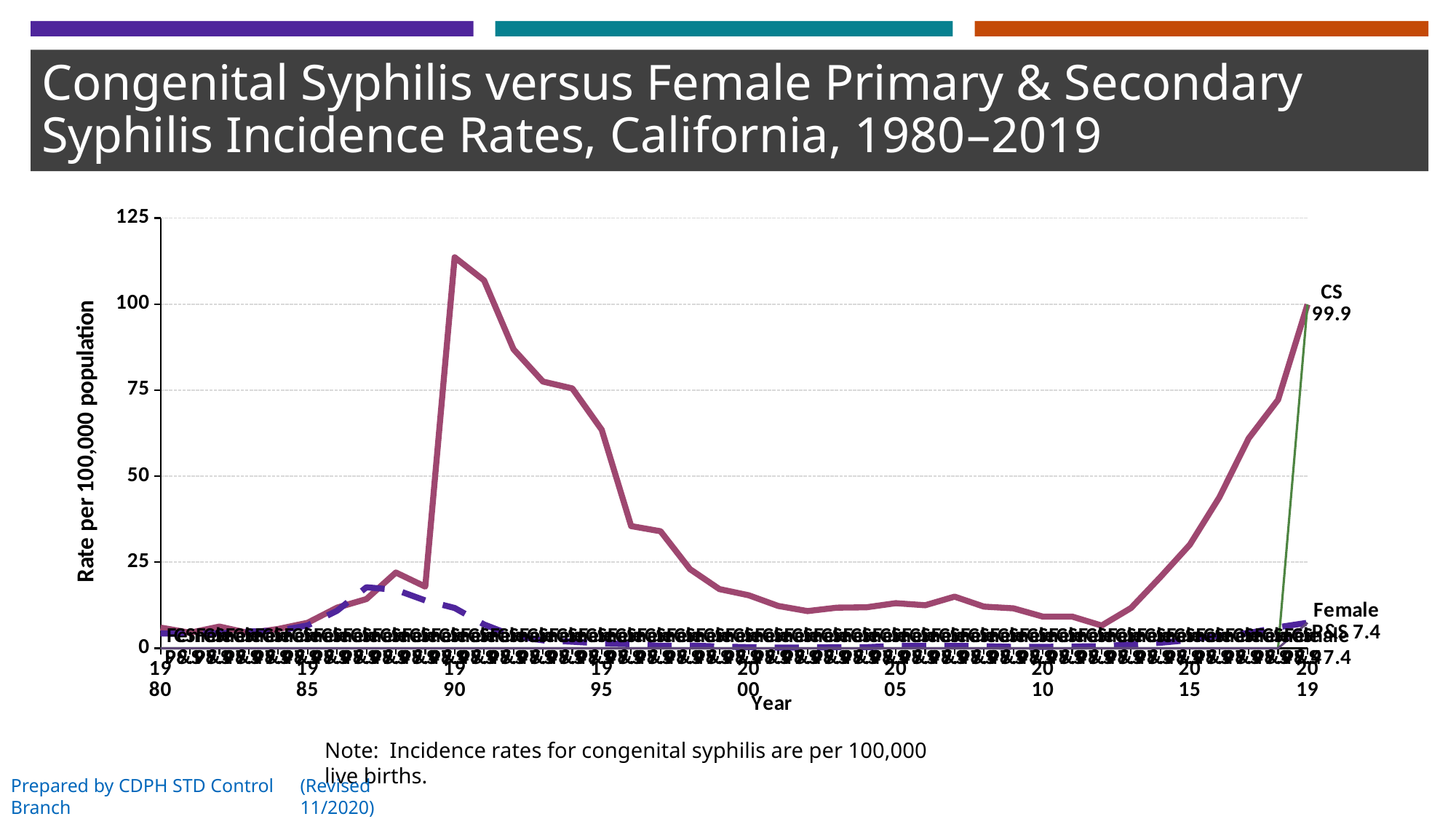
What is the CS (congenital syphilis) rate in 2019? 99.9 What is the title of the y axis? Rate per 100,000 population Does the CS rate rise or fall between 2012 and 2019? rise Is the CS rate in 2005 greater or less than 25? less What kind of chart is shown on the slide? line chart What is the difference between the CS rate and the Female P&S rate in 2019? 92.5 Is the Female P&S rate in 1988 greater or less than 25? less In which year does the CS line reach its highest point? 1990 Is the CS rate in 2017 greater or less than 50? greater What is the Female P&S rate in 2019? 7.4 In 2019, which is larger: the CS rate or the Female P&S rate? CS